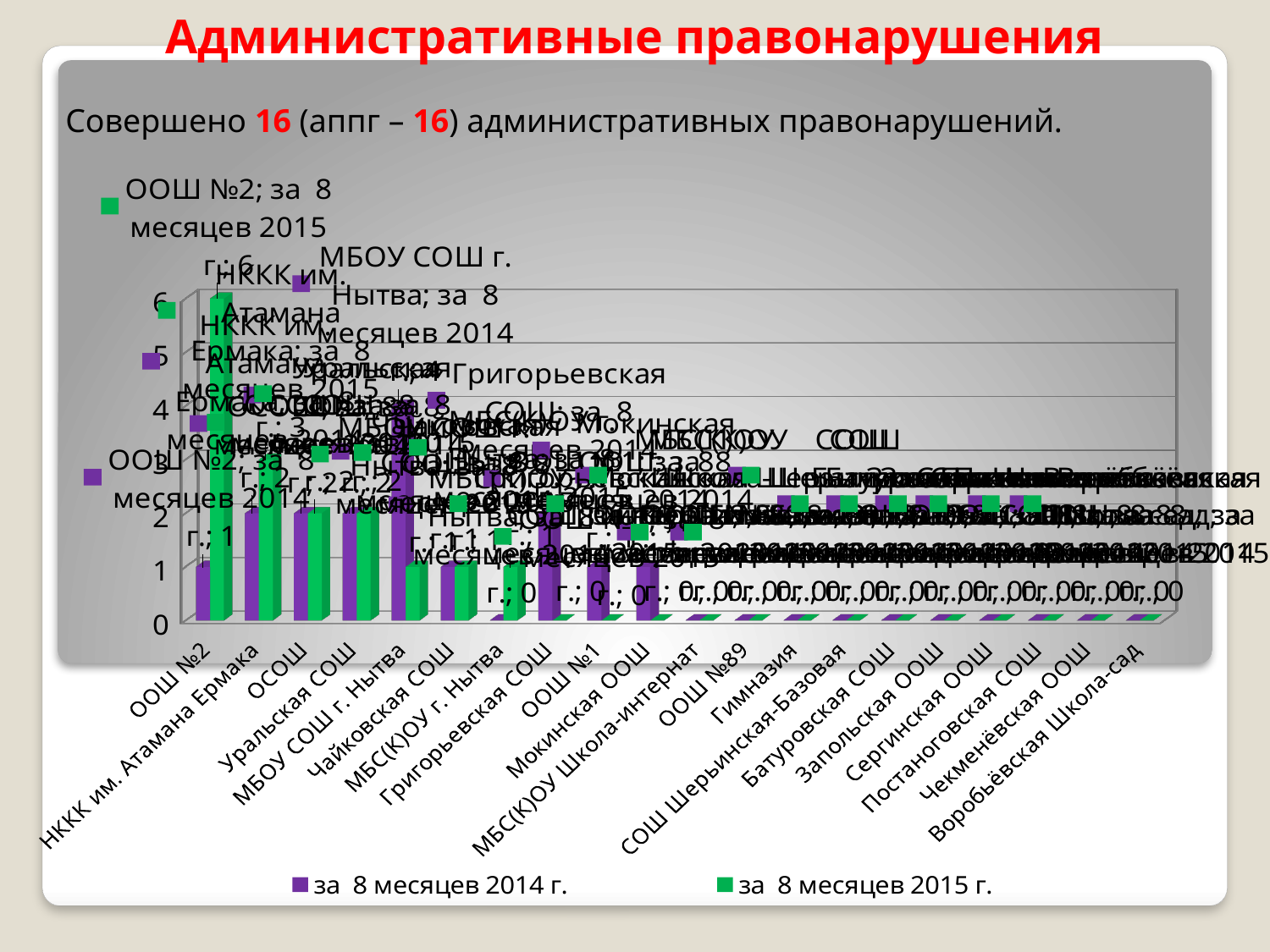
What is the title of the slide containing the chart? Административные правонарушения Which school has the highest value in the series 'за 8 месяцев 2015 г.'? ООШ №2 Is the value for Воробьёвская Школа-сад in the series 'за 8 месяцев 2015 г.' greater or less than 1? less What is the value for ООШ №2 in the series 'за 8 месяцев 2015 г.'? 6 For ООШ №2, which is larger: the value for 8 months of 2014 or for 8 months of 2015? за 8 месяцев 2015 г. What are the two series named in the legend? за 8 месяцев 2014 г. and за 8 месяцев 2015 г. How many schools (categories) are shown on the x axis of the chart? 20 How many series does the chart legend list? 2 What kind of chart is shown on the slide? bar chart What is the difference between the 2015 and 2014 values for ООШ №2? 5 What is the value for ООШ №2 in the series 'за 8 месяцев 2014 г.'? 1 Is the value for ООШ №2 in the series 'за 8 месяцев 2015 г.' greater or less than 5? greater